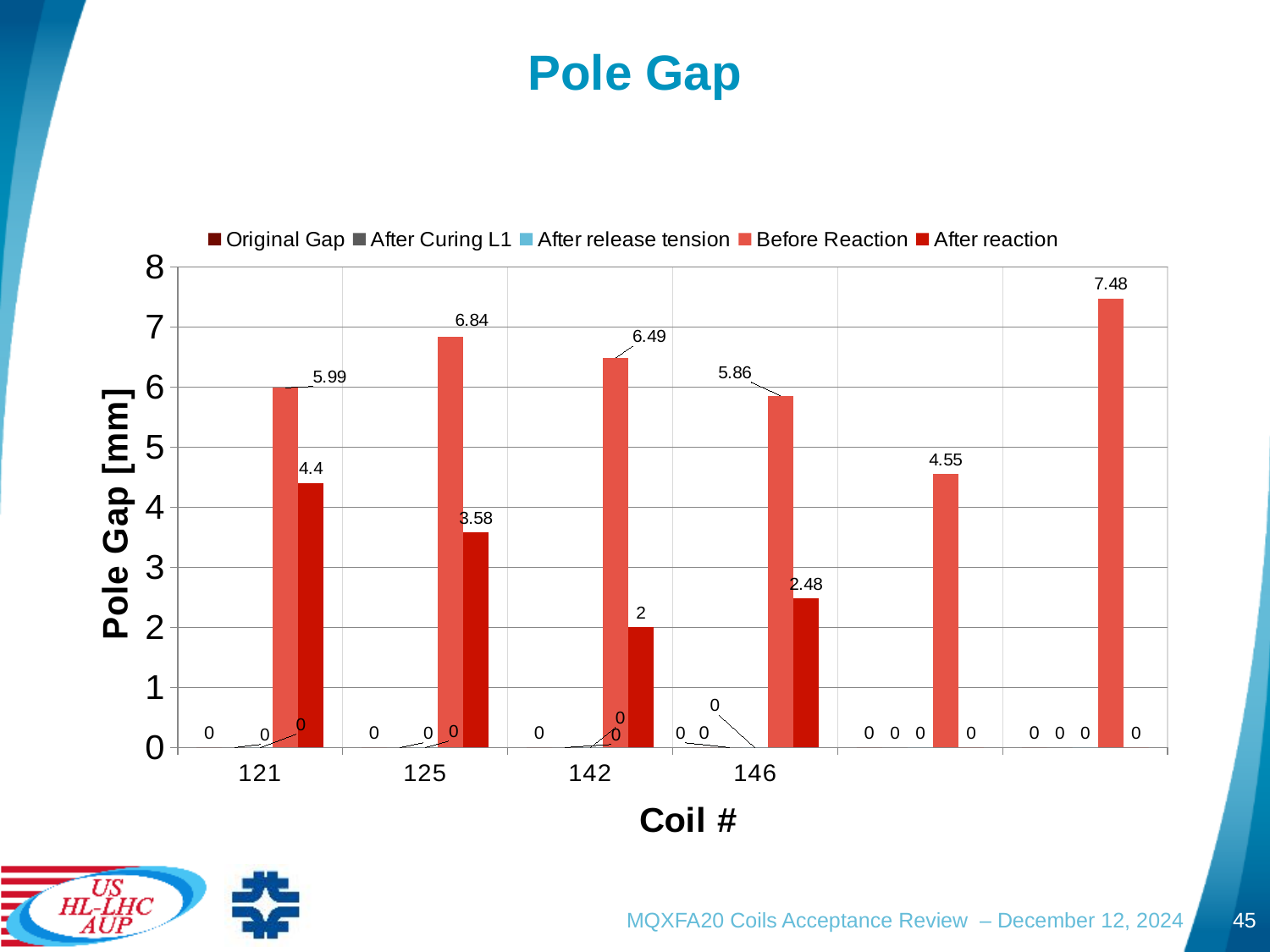
Is the Before Reaction pole gap for coil 125 greater or less than 6? greater What is the Before Reaction pole gap for coil 142? 6.49 For coil 121, what is the difference between the Before Reaction and After reaction pole gap values? 1.59 Among coils 121, 125, 142 and 146, which has the highest Before Reaction pole gap? 125 What is the Before Reaction pole gap for coil 121? 5.99 What is the After reaction pole gap for coil 125? 3.58 What is the After reaction pole gap for coil 146? 2.48 What is the After reaction pole gap for coil 121? 4.4 How many series does the legend list? 5 What kind of chart is shown on the slide? bar chart Which coil has the larger Before Reaction pole gap, 142 or 146? 142 Among coils 121, 125, 142 and 146, which has the lowest After reaction pole gap? 142